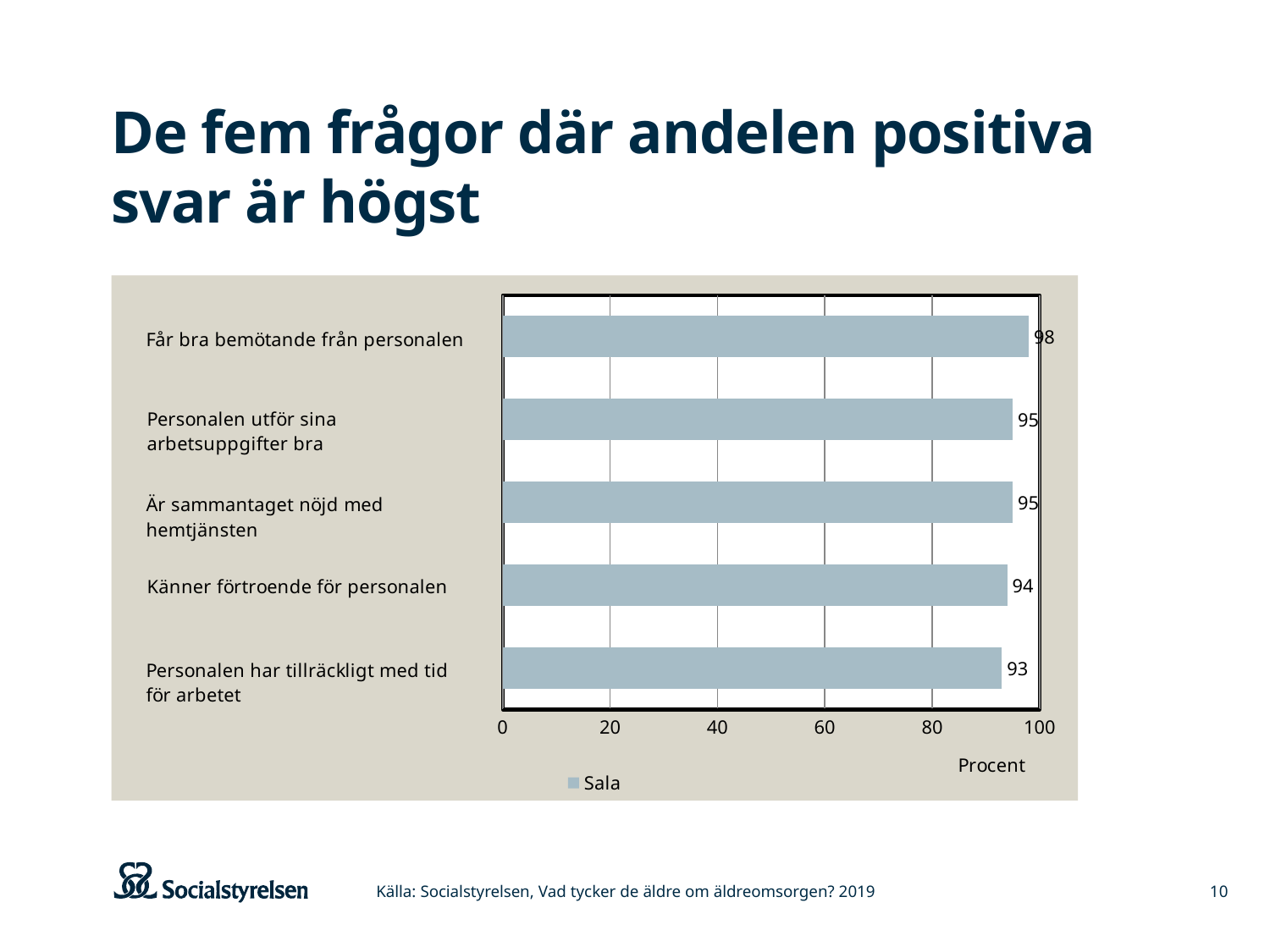
What is the value for "Personalen har tillräckligt med tid för arbetet"? 93 What is the value for "Är sammantaget nöjd med hemtjänsten"? 95 What is the difference between the values for "Får bra bemötande från personalen" and "Personalen har tillräckligt med tid för arbetet"? 5 Which category has the lowest value? Personalen har tillräckligt med tid för arbetet What is the value for "Känner förtroende för personalen"? 94 How many categories are shown in the chart? 5 What kind of chart is shown on the slide? bar chart Is the value for "Personalen har tillräckligt med tid för arbetet" greater or less than 80? greater Which is larger, the value for "Känner förtroende för personalen" or the value for "Personalen utför sina arbetsuppgifter bra"? Personalen utför sina arbetsuppgifter bra How many series does the legend list? 1 What is the value for "Får bra bemötande från personalen"? 98 Which category has the highest value? Får bra bemötande från personalen